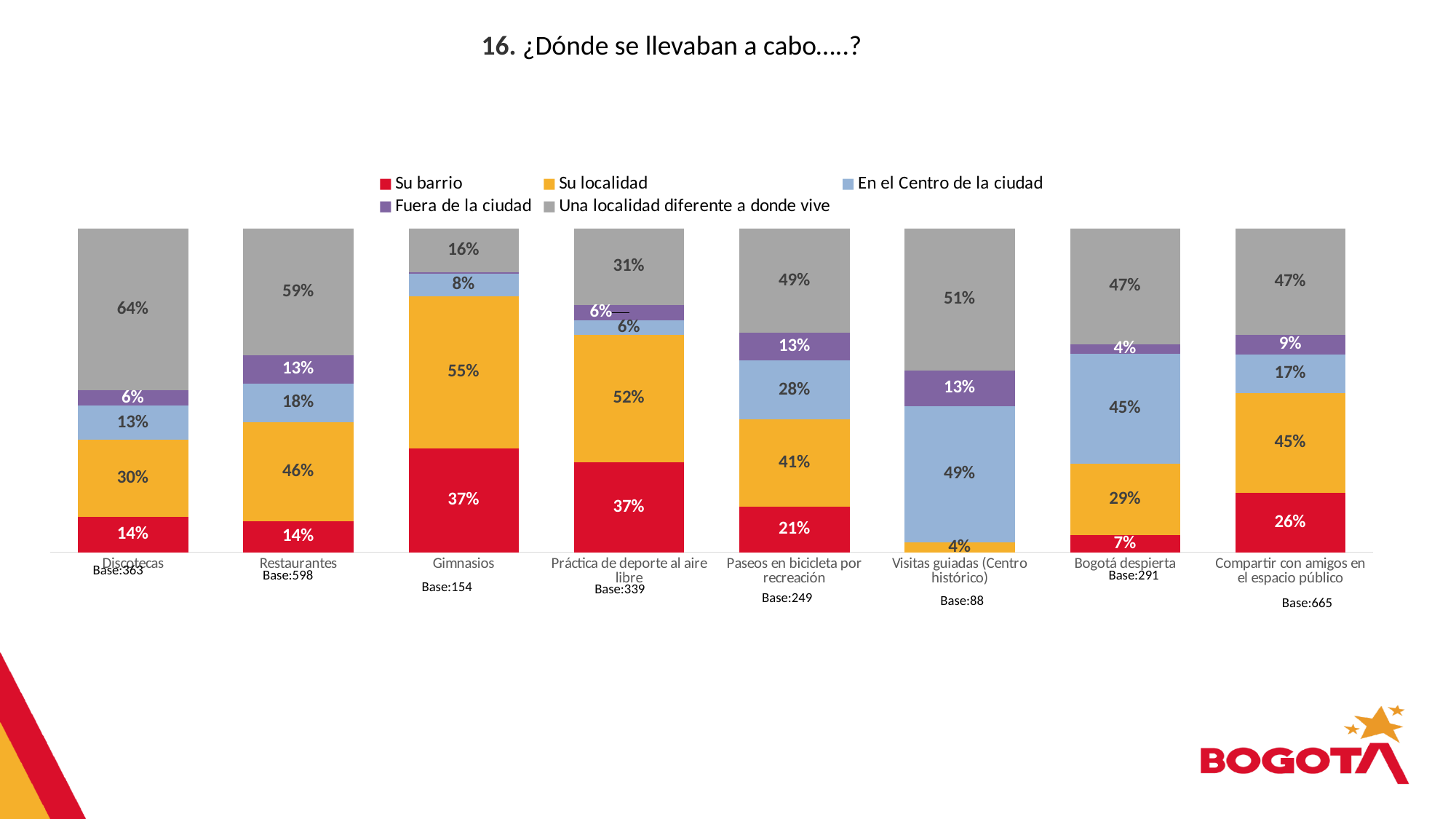
What is the value of 'Una localidad diferente a donde vive' for Discotecas? 64% What percentage is shown for 'Su localidad' in the Gimnasios bar? 55% How many categories (activities) are shown along the x axis? 8 What kind of chart is shown on the slide? Stacked bar chart What is the 'Fuera de la ciudad' value for Paseos en bicicleta por recreación? 13% Which category has the highest 'Su localidad' value? Gimnasios Which category has the lowest 'Una localidad diferente a donde vive' value? Gimnasios How many series does the legend list? 5 For Restaurantes, how many percentage points higher is 'Su localidad' than 'Su barrio'? 32 percentage points What percentage is shown for 'En el Centro de la ciudad' in the Visitas guiadas (Centro histórico) bar? 49% What colour represents 'Su barrio' in the legend? Red Which has a larger 'En el Centro de la ciudad' value: Bogotá despierta or Compartir con amigos en el espacio público? Bogotá despierta